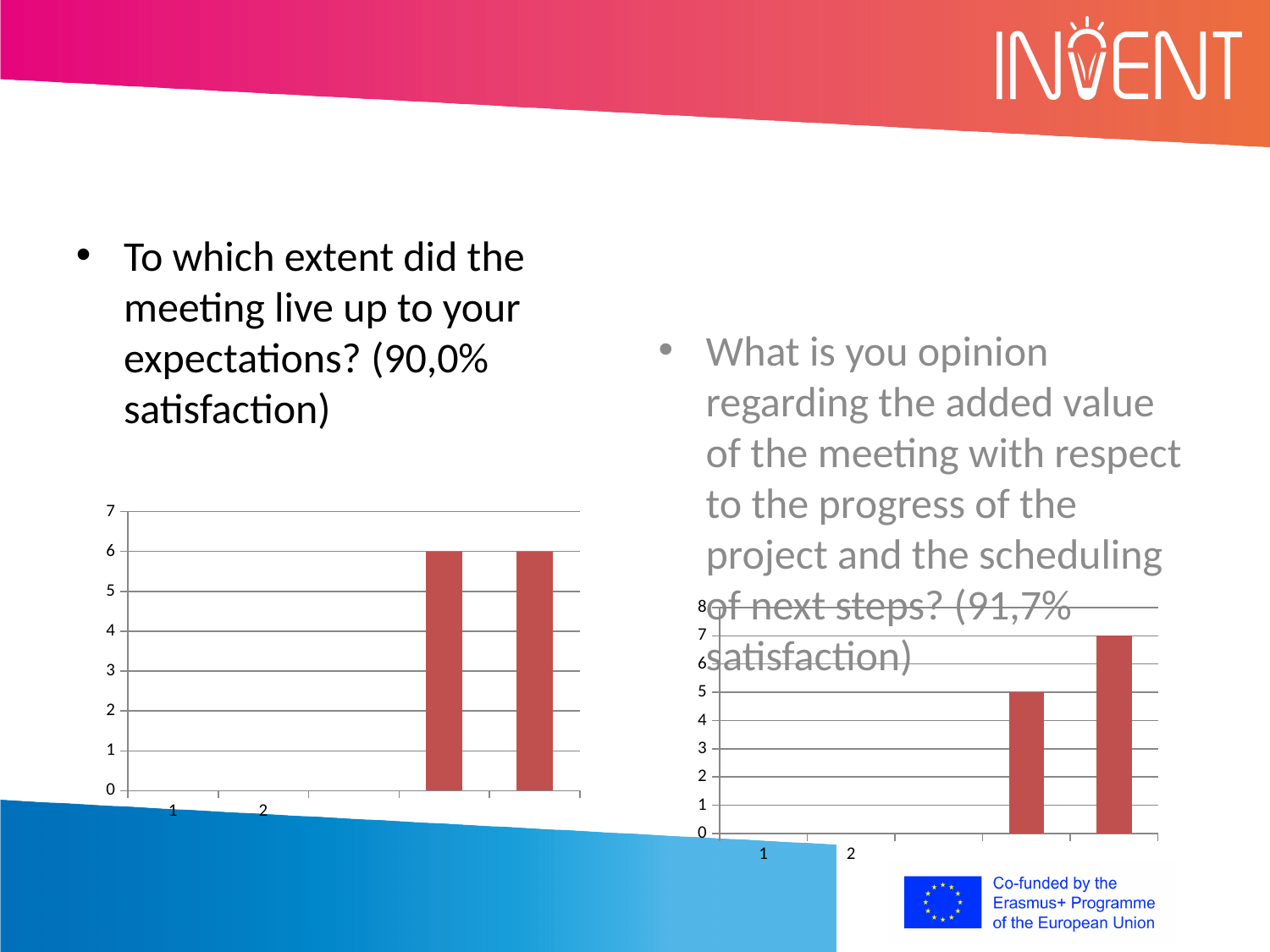
In the chart on the left side of the slide, how many bars are plotted? 2 In the chart on the right side of the slide, how many bars are plotted? 2 In the chart on the right side of the slide, what is the difference between the right-hand bar and the left-hand bar? 2 In the chart on the right side of the slide, which bar is the tallest? the right-hand bar In the chart on the left side of the slide, what value does the right-hand bar reach? 6 What kind of chart is the chart on the right side of the slide? bar chart In the chart on the left side of the slide, what value does the left-hand bar reach? 6 What kind of chart is the chart on the left side of the slide? bar chart In the chart on the right side of the slide, what value does the right-hand bar reach? 7 In the chart on the left side of the slide, what is the highest value shown on the vertical axis? 7 In the chart on the right side of the slide, what value does the left-hand bar reach? 5 In the chart on the right side of the slide, do the bar values rise or fall from left to right? rise